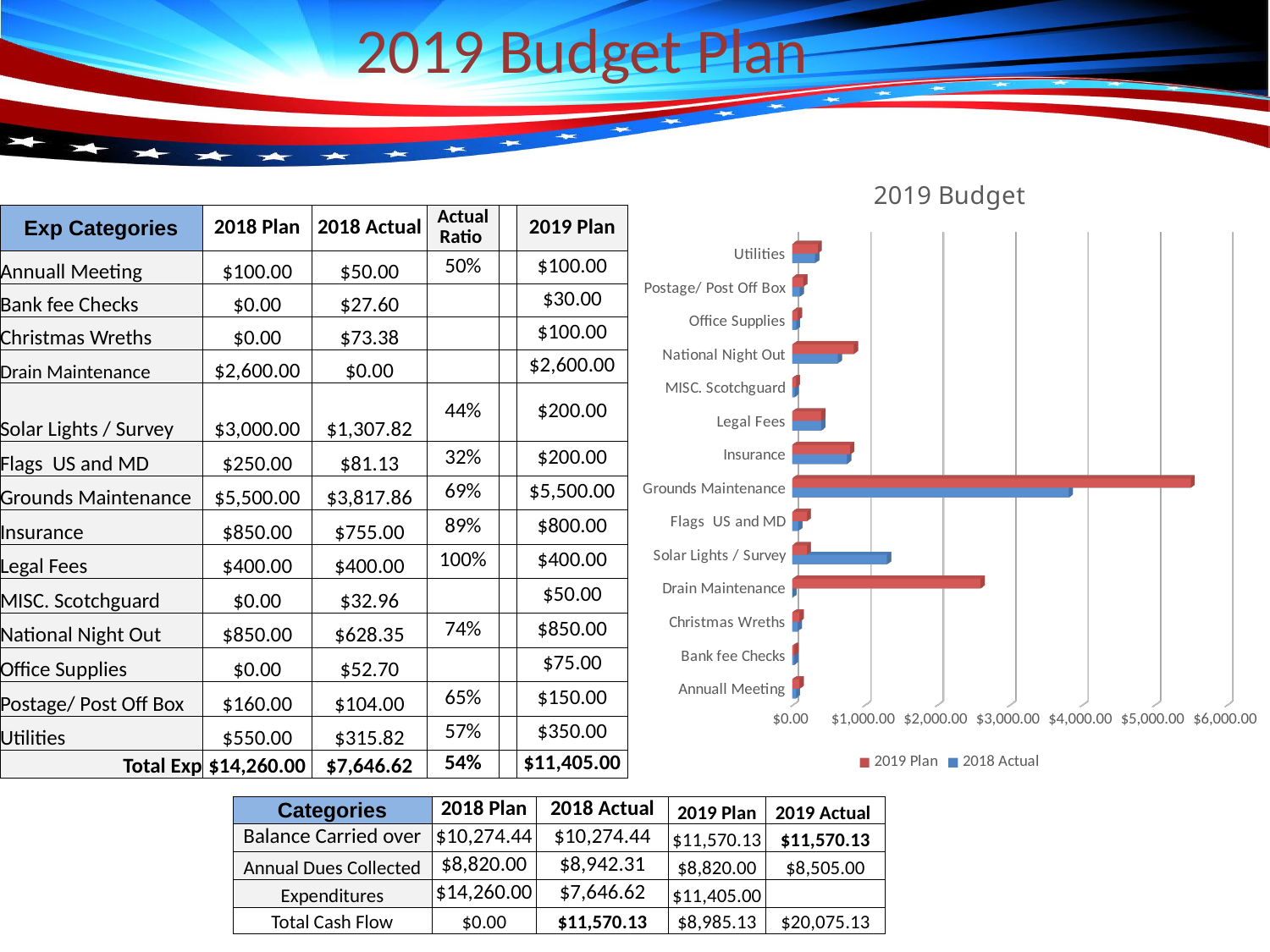
Which category has the highest 2018 Actual value in the chart? Grounds Maintenance Which is larger: the 2019 Plan for Drain Maintenance or the 2018 Actual for Solar Lights / Survey? 2019 Plan for Drain Maintenance Is the 2019 Plan value for Grounds Maintenance greater or less than $5,000.00? greater Which series is drawn in red in the chart? 2019 Plan Is the 2018 Actual value for Solar Lights / Survey greater or less than $1,000.00? greater What is the title of the chart? 2019 Budget Which category has the highest 2019 Plan value in the chart? Grounds Maintenance For Solar Lights / Survey, which is larger: the 2019 Plan or the 2018 Actual? 2018 Actual How many series does the chart legend list? 2 Is the 2019 Plan value for Drain Maintenance greater or less than $2,000.00? greater How many expense categories are plotted on the chart? 14 What kind of chart is shown on the slide? bar chart